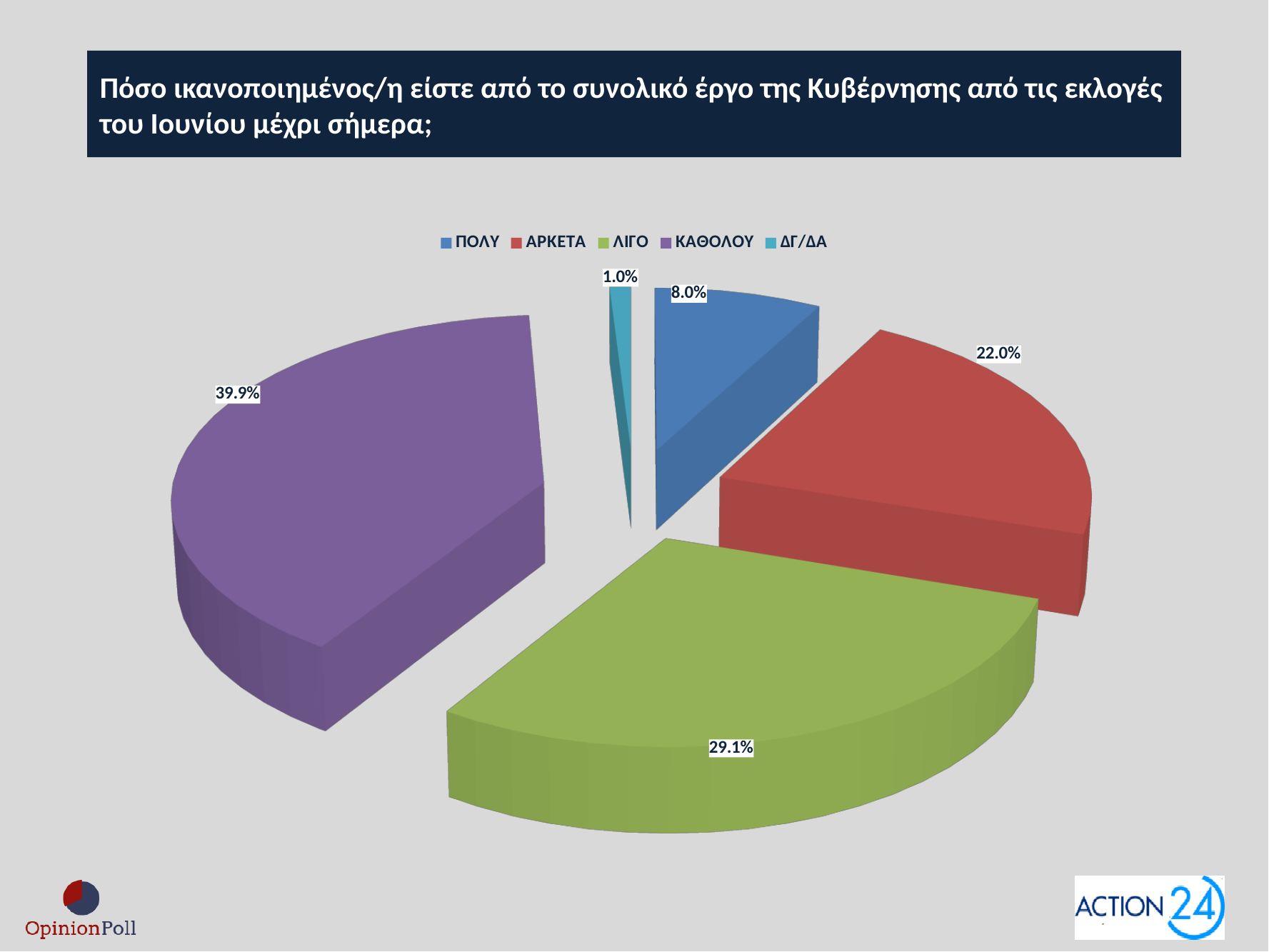
Which response has the largest share of the pie? ΚΑΘΟΛΟΥ What percentage of respondents answered ΑΡΚΕΤΑ? 22.0% How many slices does the pie chart have? 5 Which response has the smallest share of the pie? ΔΓ/ΔΑ What percentage of respondents answered ΔΓ/ΔΑ? 1.0% What is the difference in percentage points between ΚΑΘΟΛΟΥ and ΛΙΓΟ? 10.8 What percentage of respondents answered ΛΙΓΟ? 29.1% What percentage of respondents answered ΚΑΘΟΛΟΥ? 39.9% What percentage of respondents answered ΠΟΛΥ? 8.0% What colour is the slice for ΚΑΘΟΛΟΥ? Purple What kind of chart is shown on the slide? Pie chart Which is larger, the share for ΑΡΚΕΤΑ or the share for ΛΙΓΟ? ΛΙΓΟ